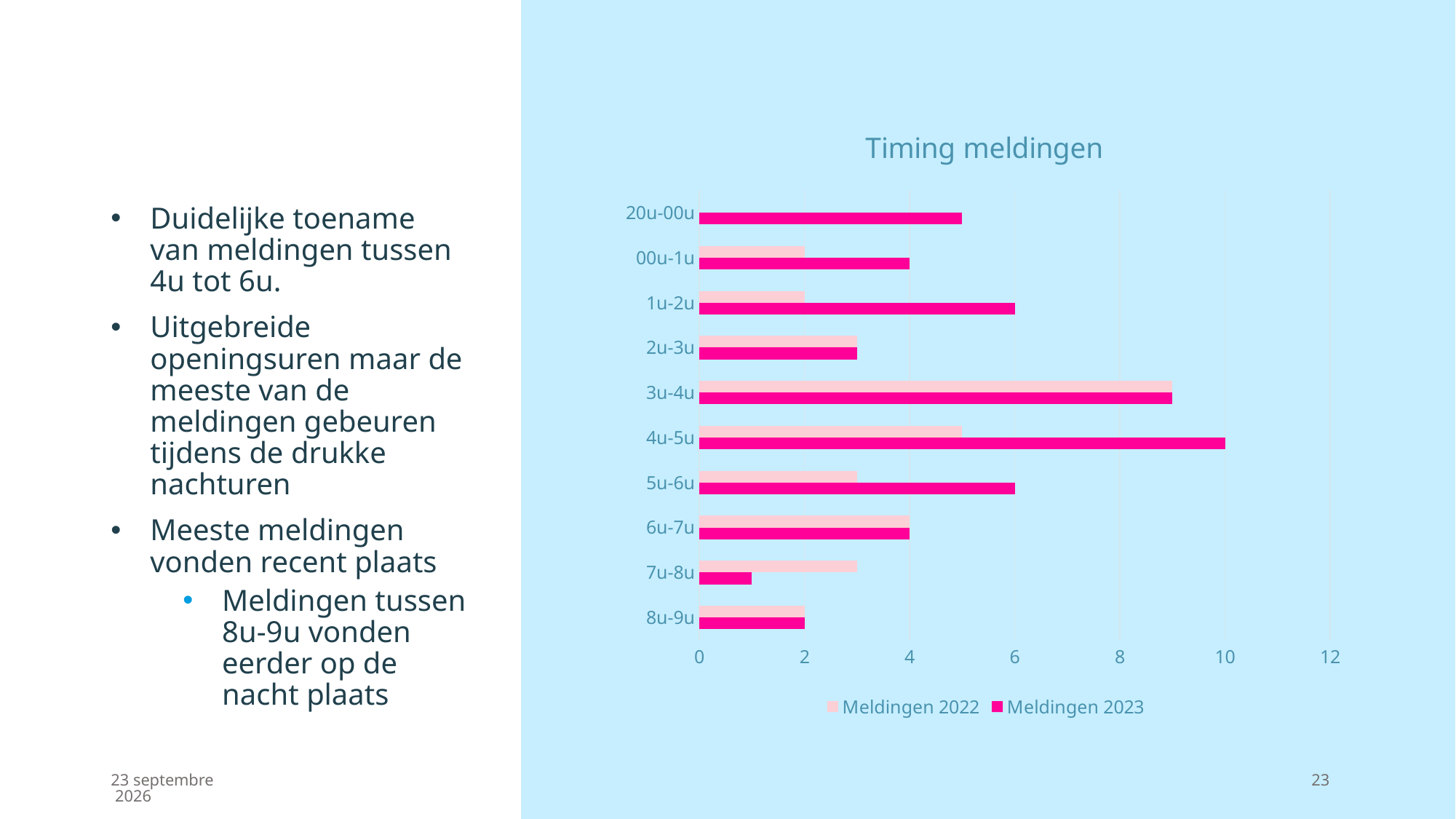
What is the value for Meldingen 2023 in the 4u-5u category? 10 How many series does the legend list? 2 How many time categories are shown on the chart? 10 What is the value for Meldingen 2022 in the 6u-7u category? 4 What is the difference between Meldingen 2023 and Meldingen 2022 in the 1u-2u category? 4 Which category has the highest value for Meldingen 2023? 4u-5u What kind of chart is shown on the slide? bar chart Which category has the lowest value for Meldingen 2023? 7u-8u Is the value for Meldingen 2023 in the 3u-4u category greater or less than 8? greater Which is larger in the 7u-8u category: Meldingen 2022 or Meldingen 2023? Meldingen 2022 What is the title of the chart? Timing meldingen What is the value for Meldingen 2023 in the 1u-2u category? 6